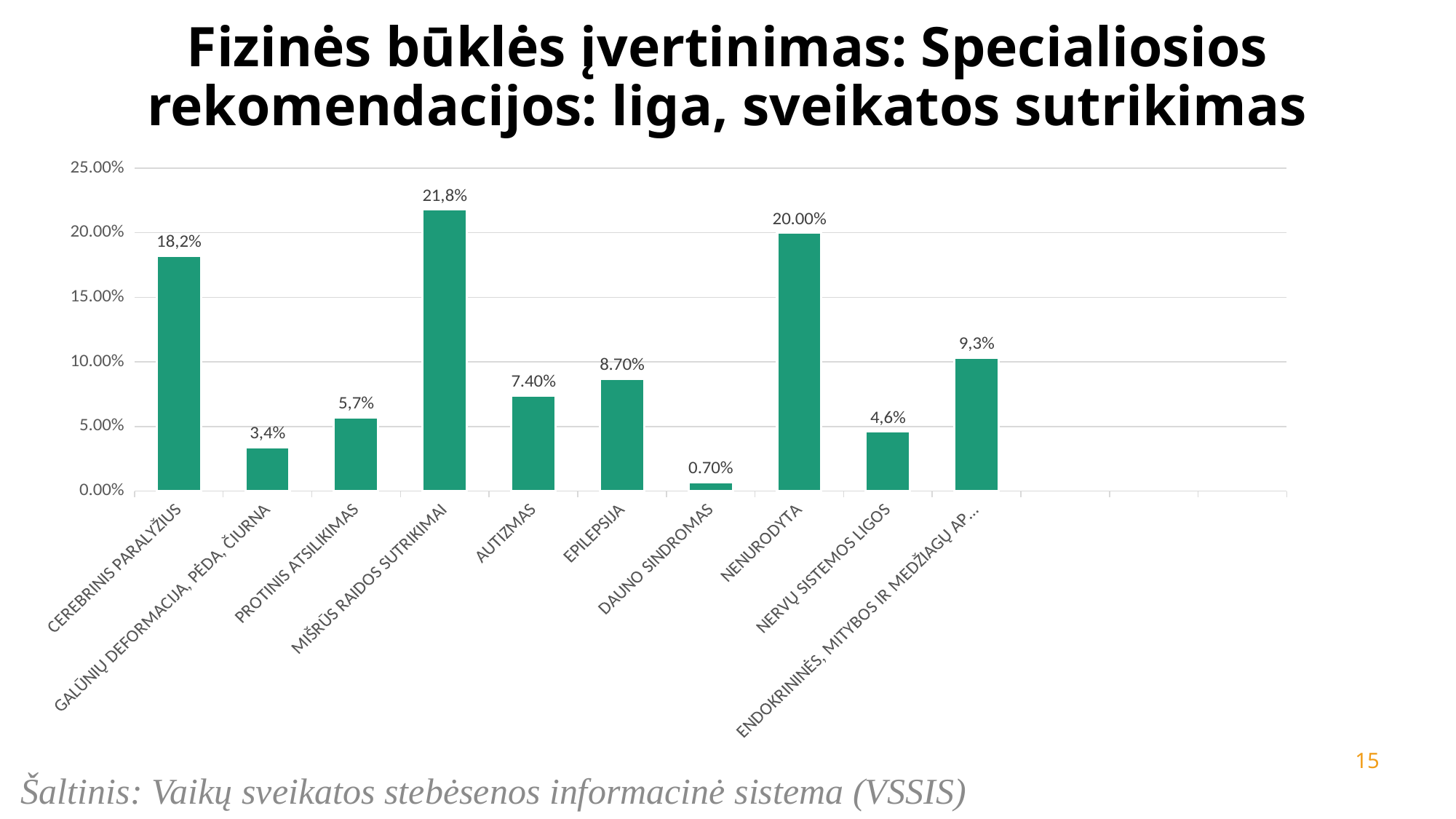
What is the value for NERVŲ SISTEMOS LIGOS? 4,6% What is the value for DAUNO SINDROMAS? 0.70% Which is larger, the value for PROTINIS ATSILIKIMAS or the value for GALŪNIŲ DEFORMACIJA, PĖDA, ČIURNA? PROTINIS ATSILIKIMAS Which category has the highest value? MIŠRŪS RAIDOS SUTRIKIMAI What is the value for MIŠRŪS RAIDOS SUTRIKIMAI? 21,8% Is the value for EPILEPSIJA greater or less than 10.00%? less How many categories are shown in the chart? 10 Which category has the lowest value? DAUNO SINDROMAS What is the difference between the values for EPILEPSIJA and AUTIZMAS? 1.30% What kind of chart is shown on the slide? bar chart What is the value for CEREBRINIS PARALYŽIUS? 18,2% What is the value for NENURODYTA? 20.00%